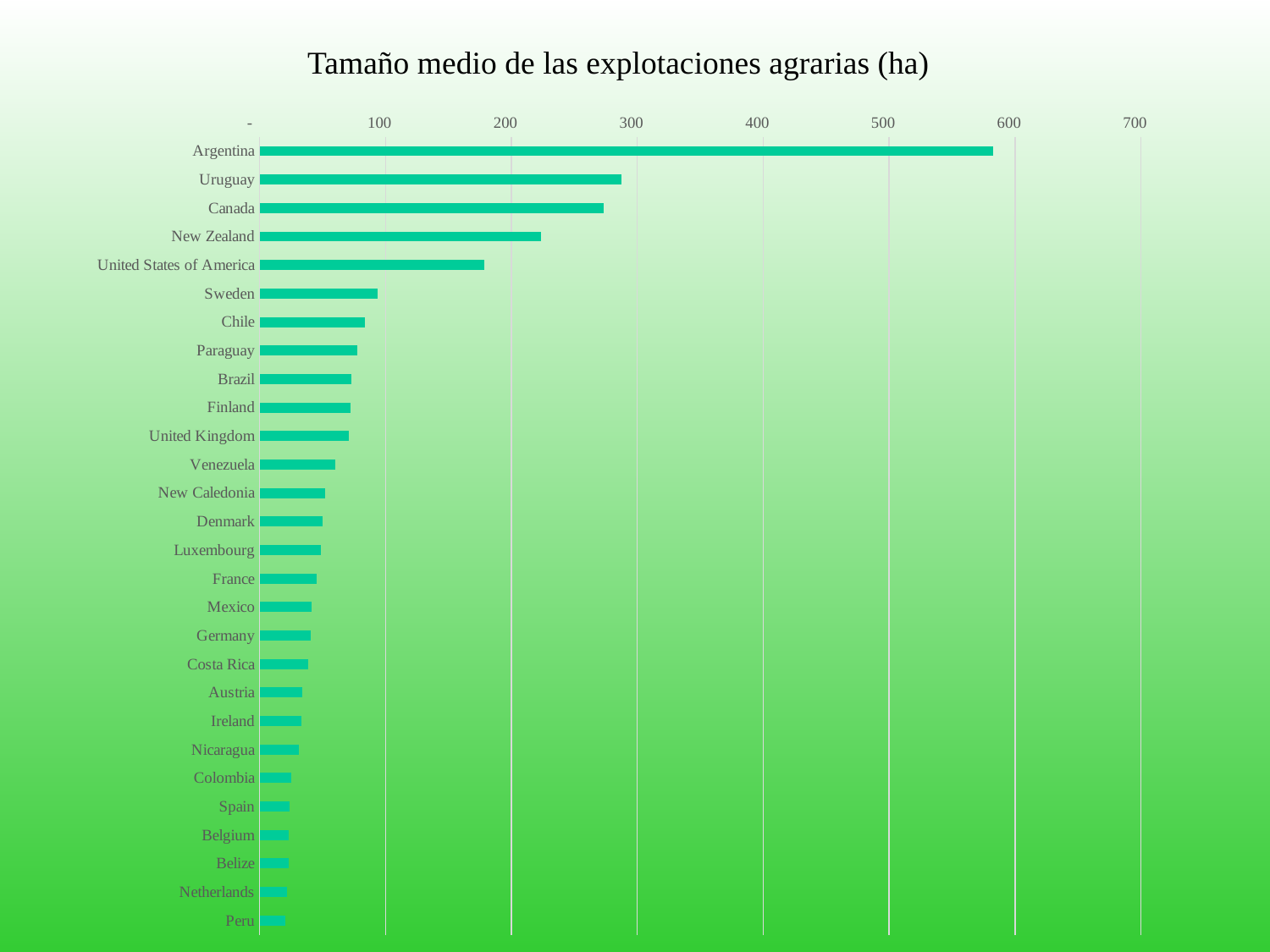
Is the value for Uruguay greater or less than 200? greater Is the value for United States of America greater or less than 200? less Which country has the highest value in the chart? Argentina How many countries are shown in the chart? 28 Which has a larger value, Argentina or Uruguay? Argentina Is the value for Argentina greater or less than 500? greater Do the bar values increase or decrease going from the top of the chart to the bottom? decrease What is the title of the chart? Tamaño medio de las explotaciones agrarias (ha) Which has a larger value, Sweden or Canada? Canada What kind of chart is shown on the slide? bar chart